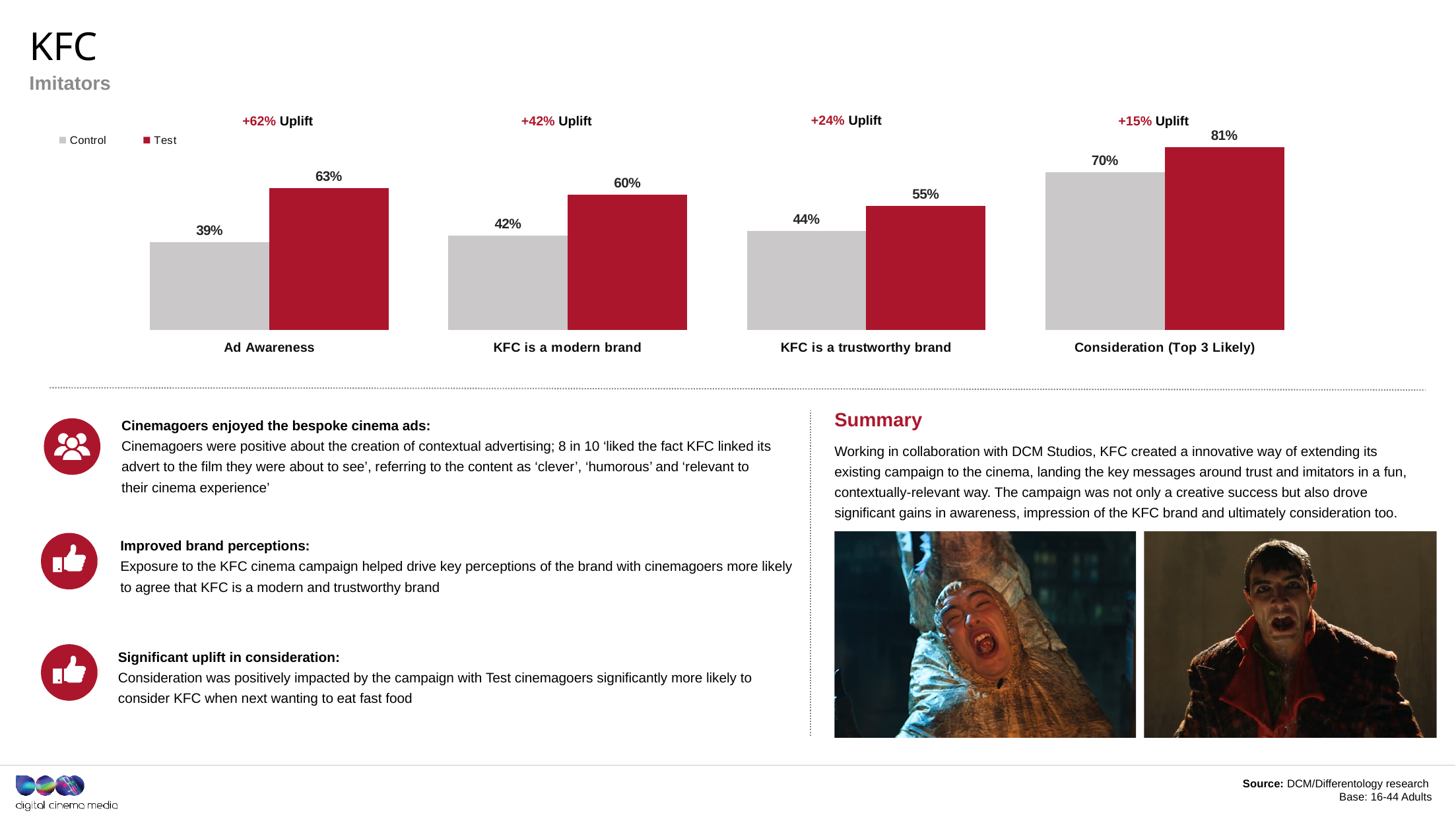
What is the Control value for KFC is a modern brand? 42% What kind of chart is shown on the slide? Bar chart Which is larger, the Control value for KFC is a trustworthy brand or the Control value for KFC is a modern brand? KFC is a trustworthy brand What is the Test value for Ad Awareness? 63% Which category has the highest Test value? Consideration (Top 3 Likely) What is the difference between the Test and Control values for Ad Awareness? 24 percentage points How many series does the legend list? 2 How many categories are shown in the chart? 4 What is the Control value for Consideration (Top 3 Likely)? 70% What is the Test value for KFC is a trustworthy brand? 55% Which category has the lowest Control value? Ad Awareness What uplift is shown above the Ad Awareness bars? +62% Uplift